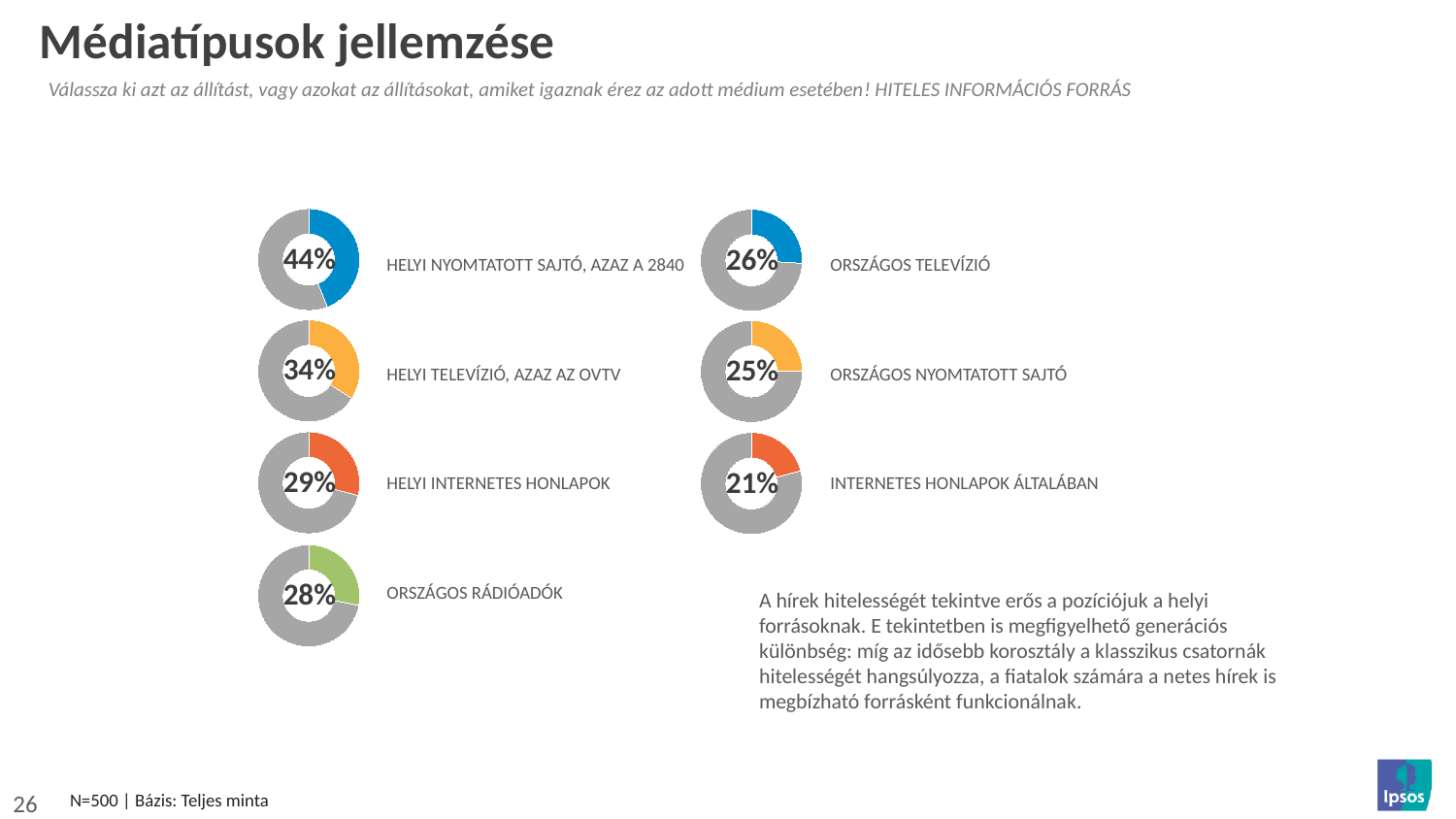
What type of chart is used to show the percentage for each medium on the slide? Donut (pie) chart How many donut charts are shown on the slide? 7 Which medium has the highest percentage among the donut charts on the slide? HELYI NYOMTATOTT SAJTÓ, AZAZ A 2840 What percentage is shown in the donut chart labelled HELYI NYOMTATOTT SAJTÓ, AZAZ A 2840? 44% Which is larger: the percentage for HELYI INTERNETES HONLAPOK or the percentage for INTERNETES HONLAPOK ÁLTALÁBAN? HELYI INTERNETES HONLAPOK What percentage is shown in the donut chart labelled INTERNETES HONLAPOK ÁLTALÁBAN? 21% What is the difference between the percentage for HELYI NYOMTATOTT SAJTÓ, AZAZ A 2840 and the percentage for ORSZÁGOS NYOMTATOTT SAJTÓ? 19 percentage points What colour is the highlighted segment in the donut chart for ORSZÁGOS RÁDIÓADÓK? Green What is the difference between the percentage for HELYI TELEVÍZIÓ, AZAZ AZ OVTV and the percentage for ORSZÁGOS TELEVÍZIÓ? 8 percentage points What percentage is shown in the donut chart labelled ORSZÁGOS RÁDIÓADÓK? 28% Which medium has the lowest percentage among the donut charts on the slide? INTERNETES HONLAPOK ÁLTALÁBAN What percentage is shown in the donut chart labelled ORSZÁGOS TELEVÍZIÓ? 26%